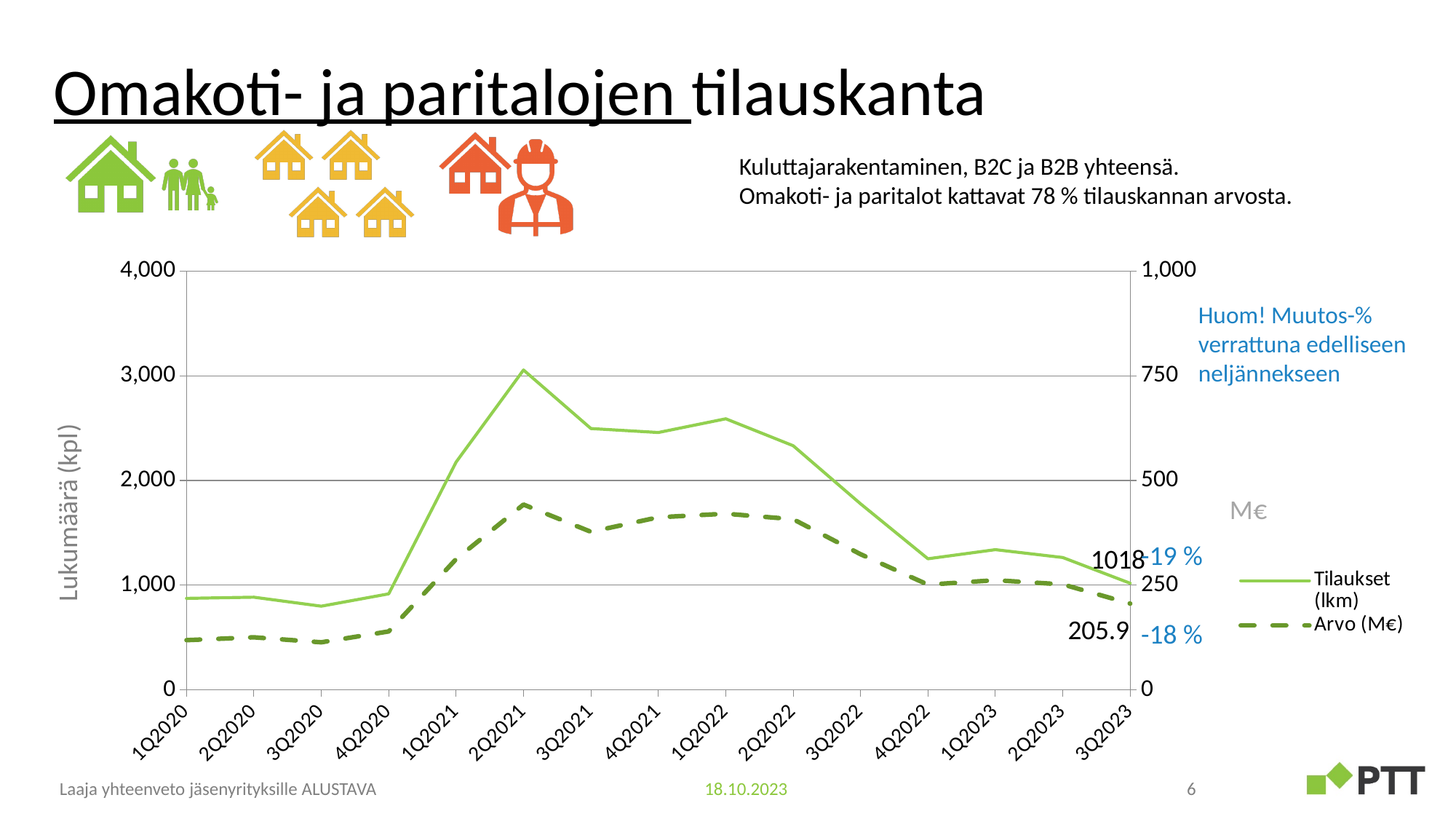
How many series does the chart legend list? 2 In which quarter is Tilaukset (lkm) at its lowest? 3Q2020 How many quarters are plotted along the x axis? 15 What kind of chart is shown on the slide? line chart What is the title of the left vertical axis? Lukumäärä (kpl) Is the value of Tilaukset (lkm) at 1Q2020 greater or less than 1,000? less Does Tilaukset (lkm) rise or fall from 2Q2021 to 4Q2022? fall In which quarter does Tilaukset (lkm) reach its highest value? 2Q2021 What is the value of Arvo (M€) at 3Q2023? 205.9 What is the value of Tilaukset (lkm) at 3Q2023? 1018 Which is larger, Tilaukset (lkm) at 2Q2021 or at 1Q2022? 2Q2021 Is the value of Tilaukset (lkm) at 4Q2022 greater or less than 1,000? greater